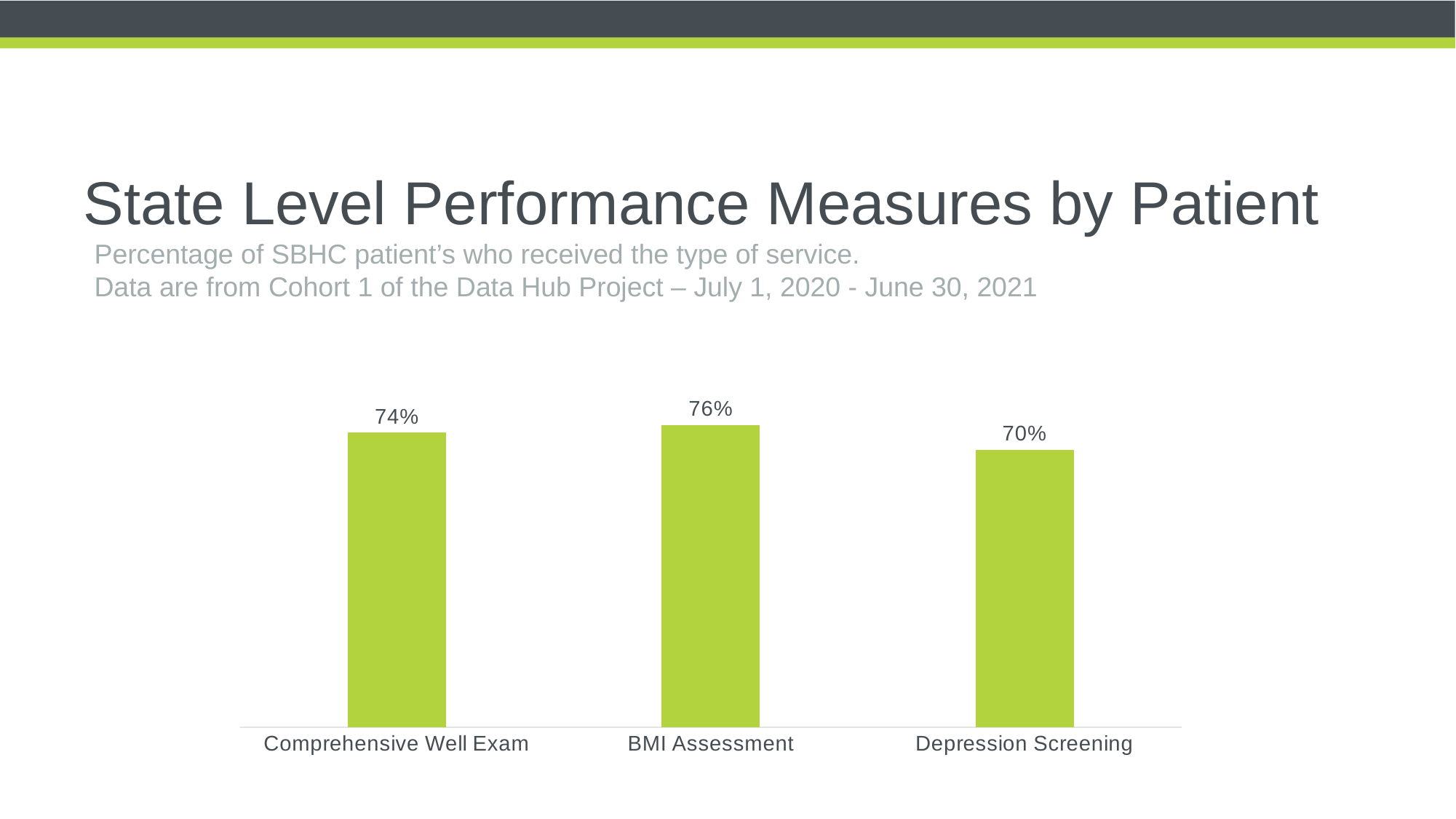
What kind of chart is shown on the slide? Bar chart What is the value shown for Depression Screening? 70% What is the difference between the BMI Assessment and Depression Screening percentages? 6% What percentage of SBHC patients received a Comprehensive Well Exam? 74% What colour are the bars in the chart? Green Which service has the lowest percentage of patients? Depression Screening Which is larger, the value for Comprehensive Well Exam or the value for Depression Screening? Comprehensive Well Exam What is the title of the slide containing the chart? State Level Performance Measures by Patient What is the difference between the Comprehensive Well Exam and BMI Assessment percentages? 2% What is the value shown for BMI Assessment? 76% Which service has the highest percentage of patients? BMI Assessment How many service categories are shown in the chart? 3